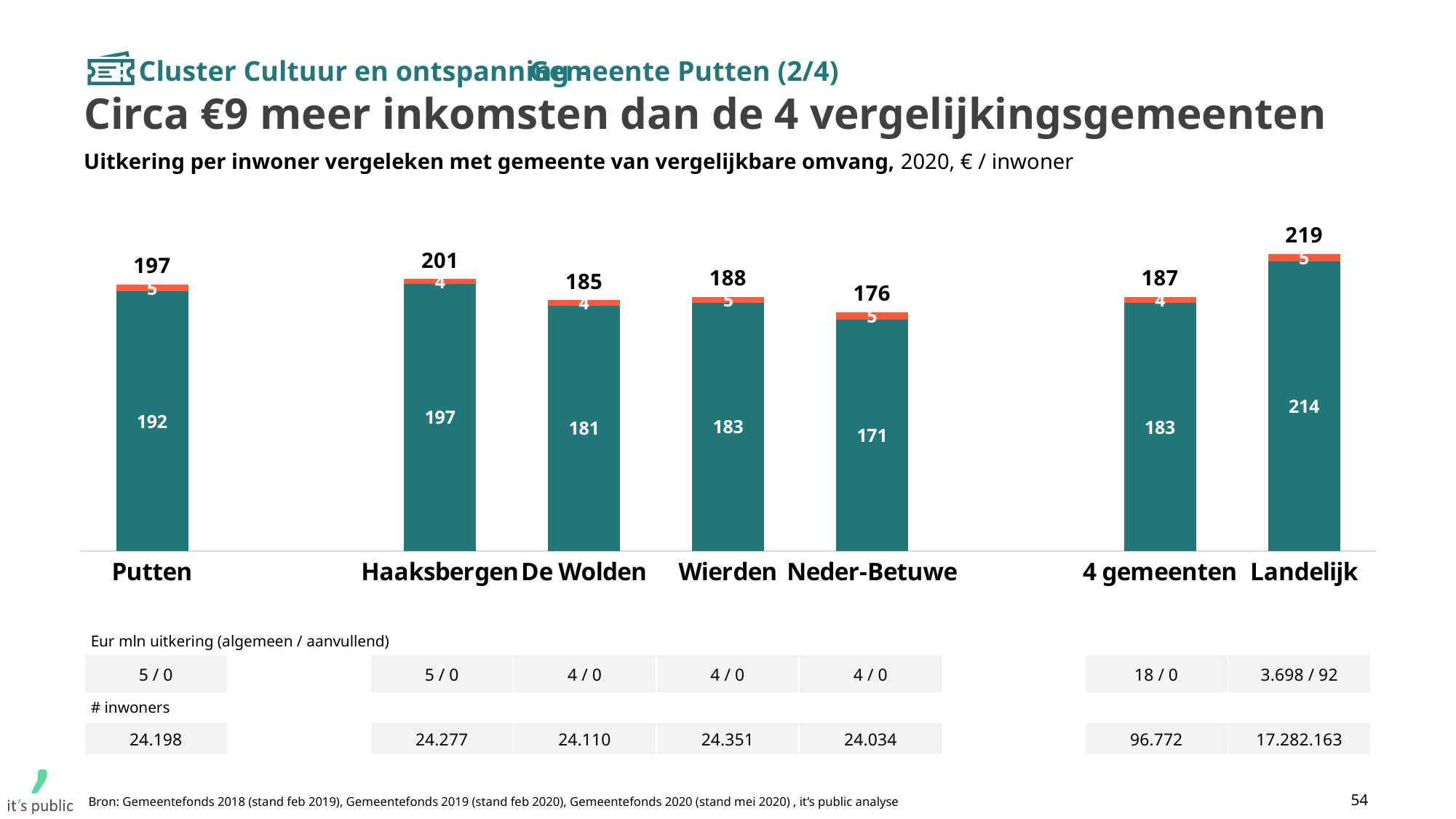
What is the difference between the total for Landelijk and the total for De Wolden? 34 What is the value of the teal (lower) segment for Landelijk? 214 How many categories are shown on the x axis of the chart? 7 Which has a larger total value, Haaksbergen or Wierden? Haaksbergen What is the total value shown above the bar for Wierden? 188 What is the value of the orange (upper) segment for Haaksbergen? 4 What is the total value shown above the bar for Putten? 197 What is the value of the teal (lower) segment for Neder-Betuwe? 171 Which category has the lowest total value? Neder-Betuwe Which category has the highest total value? Landelijk What kind of chart is shown on the slide? Stacked bar chart What is the difference between the total for Putten and the total for 4 gemeenten? 10